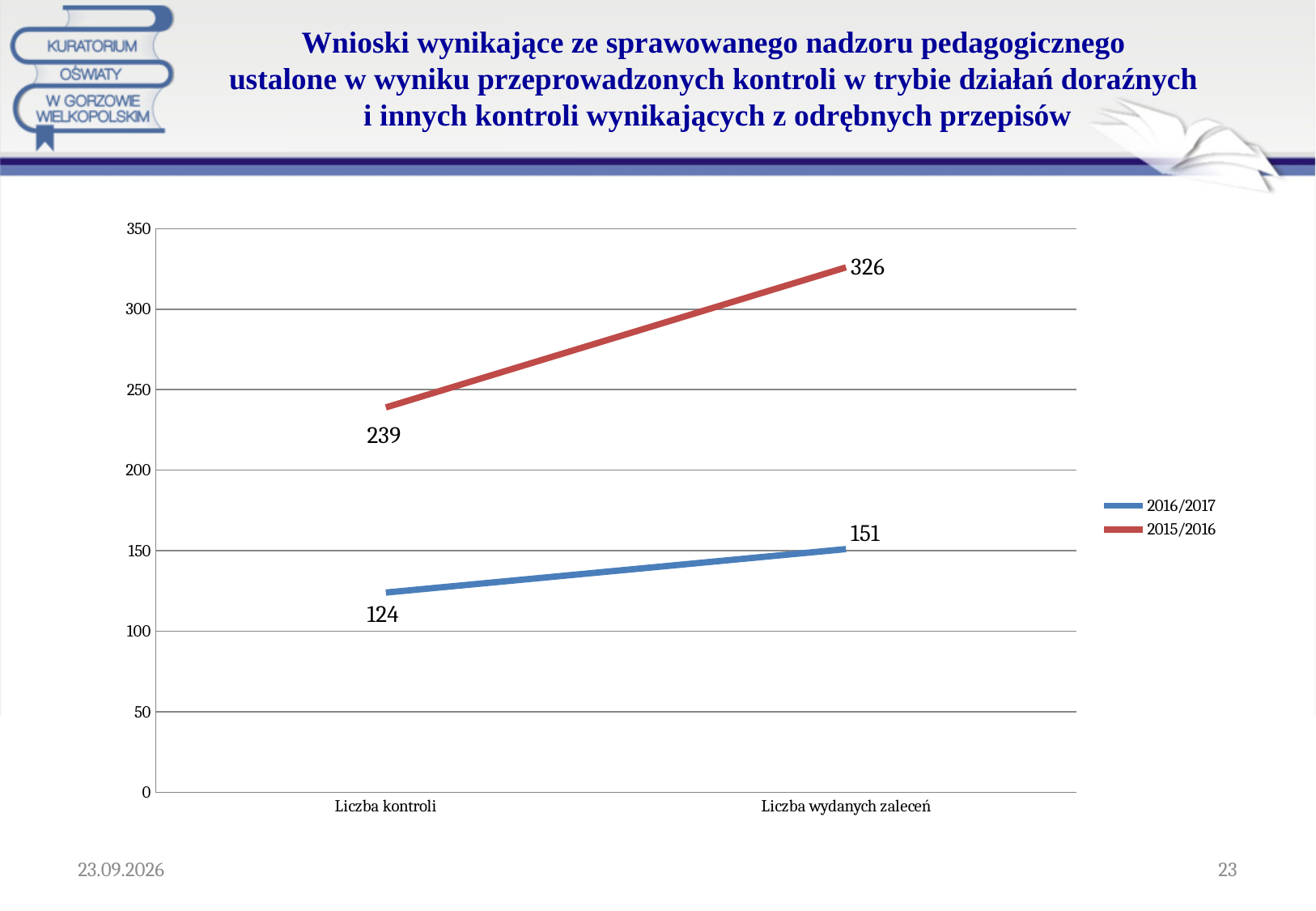
How many categories are shown on the x axis? 2 Does the 2016/2017 line rise or fall from Liczba kontroli to Liczba wydanych zaleceń? rise What is the value for 2015/2016 at Liczba kontroli? 239 What is the difference between the 2015/2016 and 2016/2017 values at Liczba kontroli? 115 What kind of chart is shown on the slide? line chart What is the value for 2015/2016 at Liczba wydanych zaleceń? 326 What is the difference between the 2015/2016 values at Liczba wydanych zaleceń and Liczba kontroli? 87 What is the value for 2016/2017 at Liczba kontroli? 124 Which series has the higher value at Liczba wydanych zaleceń? 2015/2016 What is the value for 2016/2017 at Liczba wydanych zaleceń? 151 Is the value for 2016/2017 at Liczba wydanych zaleceń greater or less than 150? greater How many series does the legend list? 2